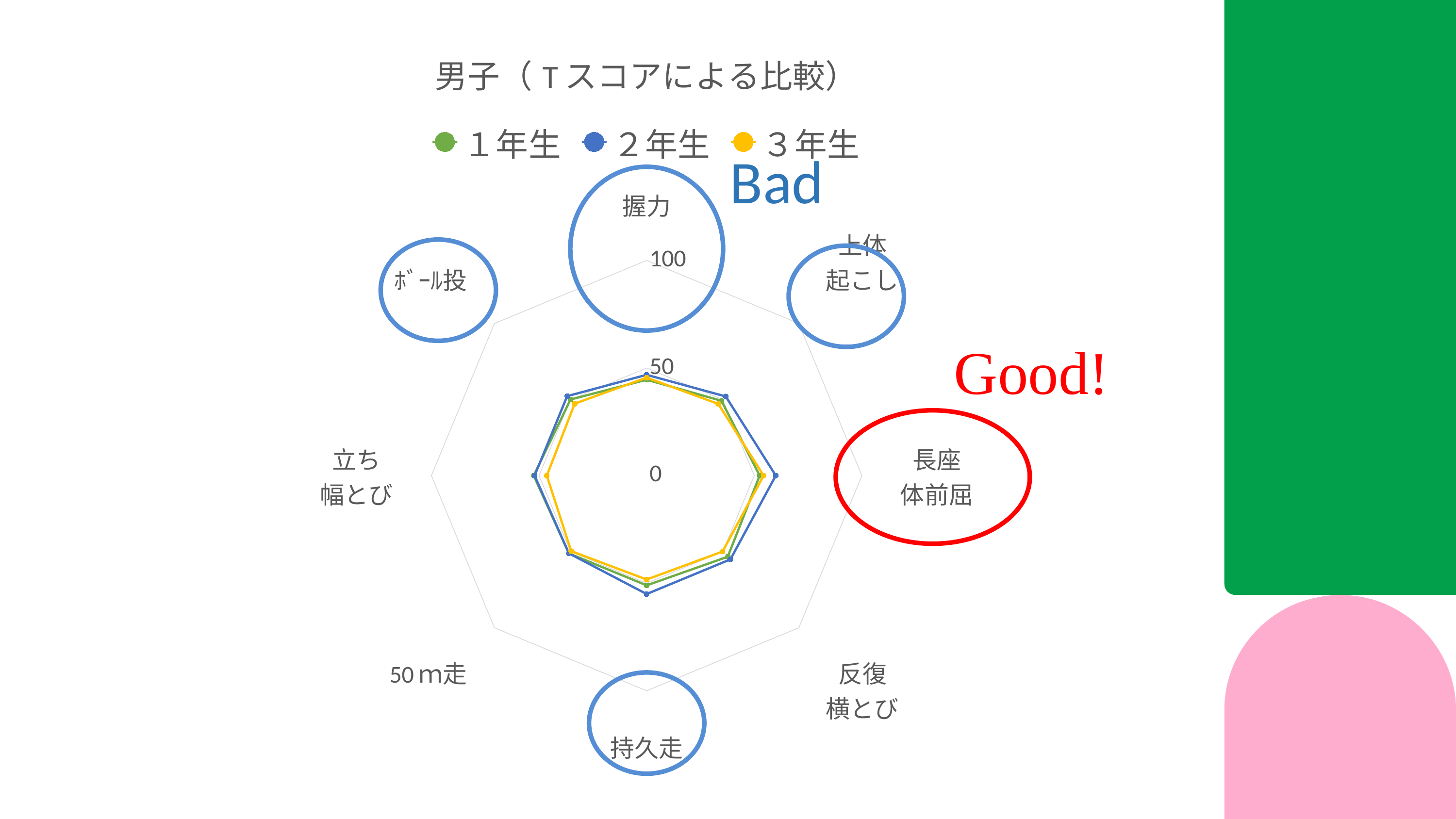
Which is larger at 持久走, the value for ２年生 or for ３年生? ２年生 Which is larger at 立ち幅とび, the value for ２年生 or for ３年生? ２年生 Which is larger at 長座体前屈, the value for ２年生 or for ３年生? ２年生 What is the title of the chart? 男子（Ｔスコアによる比較） Which series is drawn in blue? ２年生 How many series does the legend list? 3 How many categories (axes) does the radar chart have? 8 What kind of chart is shown on the slide? radar chart Is the value for ３年生 at 長座体前屈 greater or less than 100? less Is the value for ２年生 at 握力 greater or less than 100? less